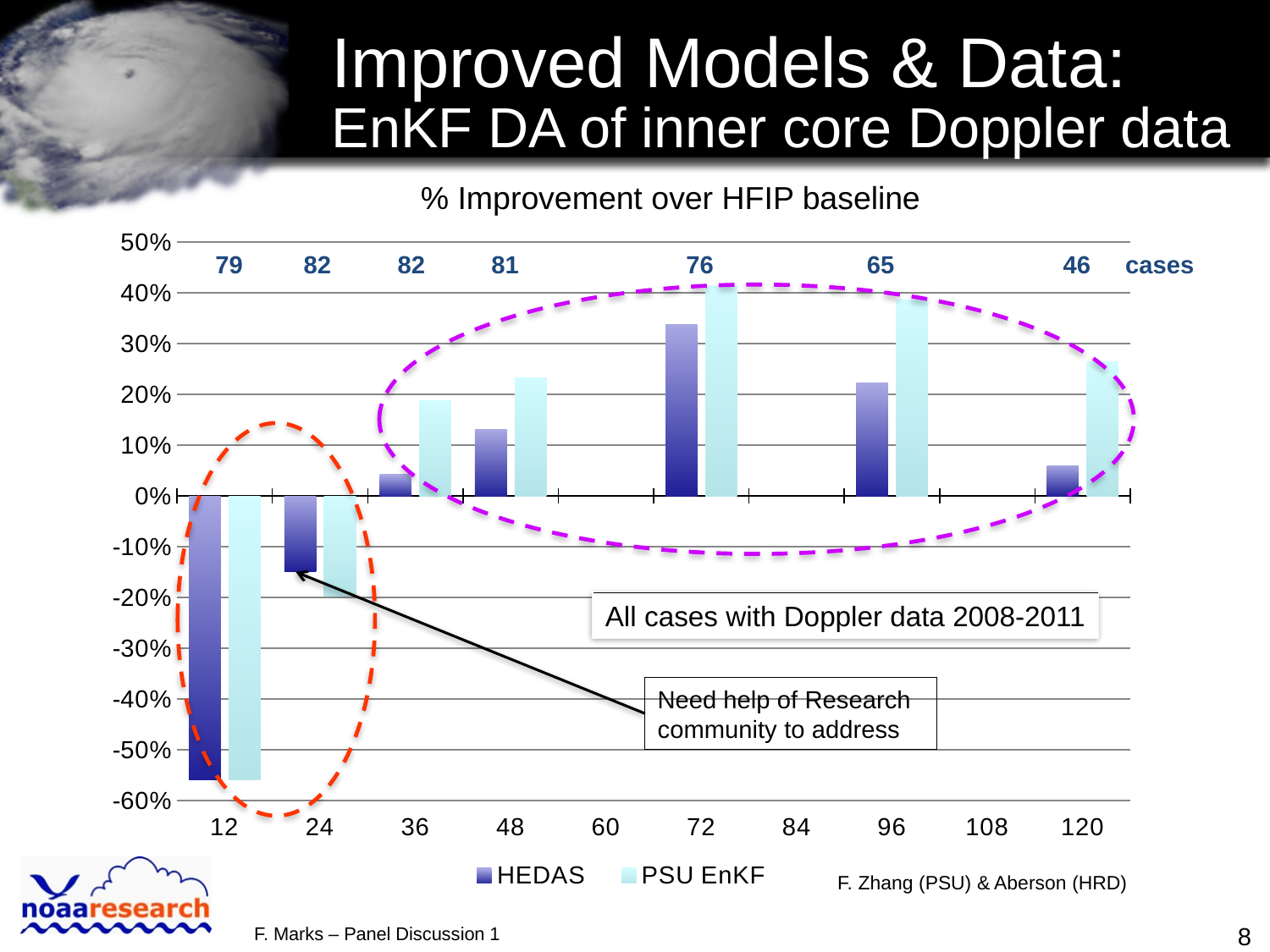
What is the title of the chart? % Improvement over HFIP baseline What are the two series named in the chart legend? HEDAS and PSU EnKF How many cases are listed above the 120-hour forecast time? 46 What kind of chart is shown on the slide? bar chart How many cases are listed above the 72-hour forecast time? 76 Is the PSU EnKF value at 72 hours greater or less than 40%? greater At which forecast time is the PSU EnKF value highest? 72 At which forecast time is the HEDAS value lowest? 12 How many cases are listed above the 12-hour forecast time? 79 Is the HEDAS value at 12 hours greater or less than -50%? less How many series does the chart legend list? 2 At 96 hours, which series has the larger value, HEDAS or PSU EnKF? PSU EnKF